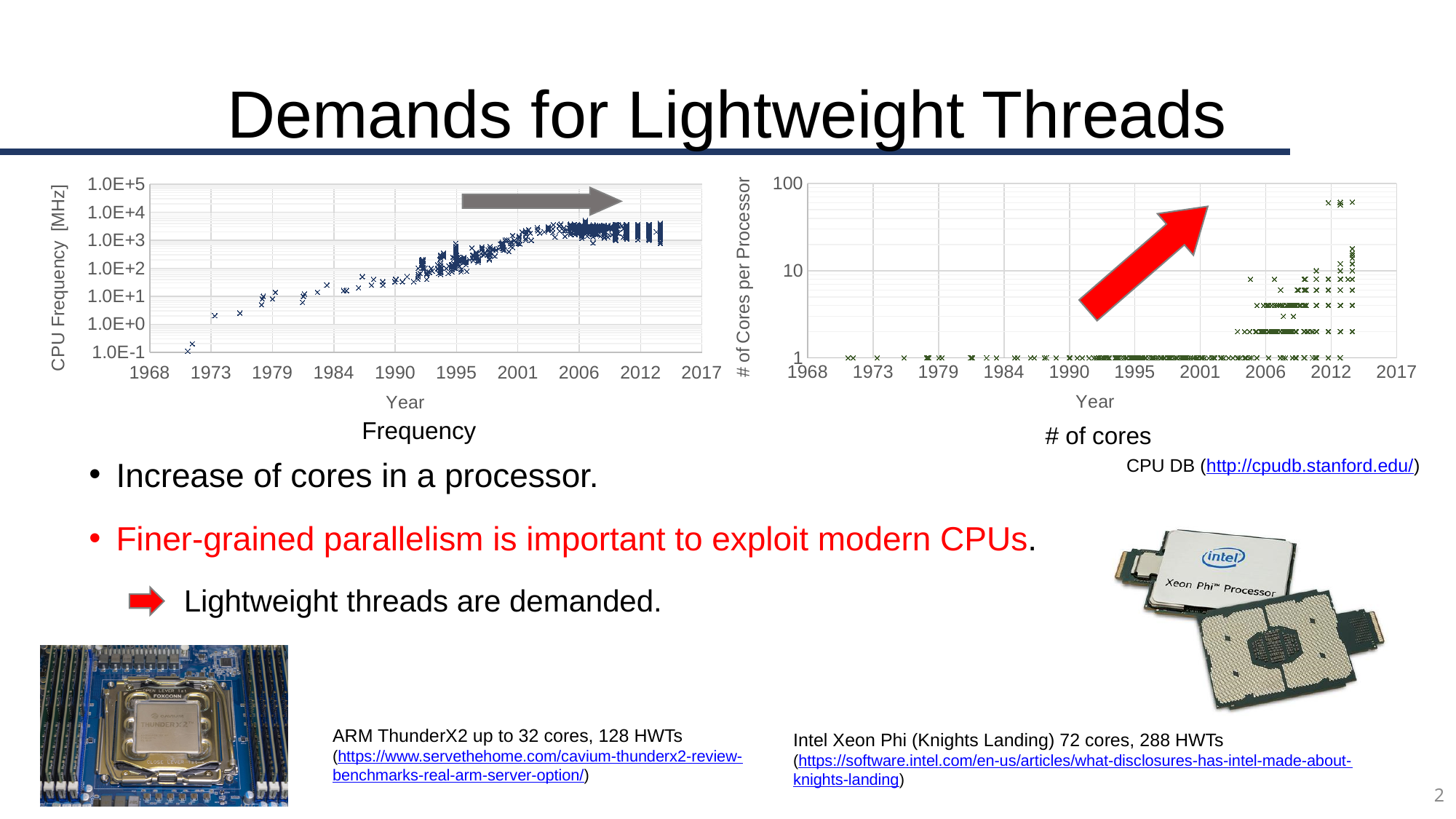
In the # of cores chart, do the number of cores per processor values rise or fall along the x axis after 2006? rise In the # of cores chart, are the points plotted before 1990 greater or less than 10? less What kind of chart is the # of cores chart on the right? scatter chart What is the y-axis label of the Frequency chart? CPU Frequency [MHz] What is the highest tick value on the y axis of the # of cores chart? 100 What is the last year shown on the x axis of the Frequency chart? 2017 What is the y-axis label of the # of cores chart? # of Cores per Processor In the Frequency chart, is the point plotted around 1973 greater or less than 1.0E+1? less In the Frequency chart, do CPU frequency values generally rise or fall from 1968 to 2012? rise In the Frequency chart, are the points plotted around 2006 greater or less than 1.0E+3? greater What kind of chart is the Frequency chart on the left? scatter chart